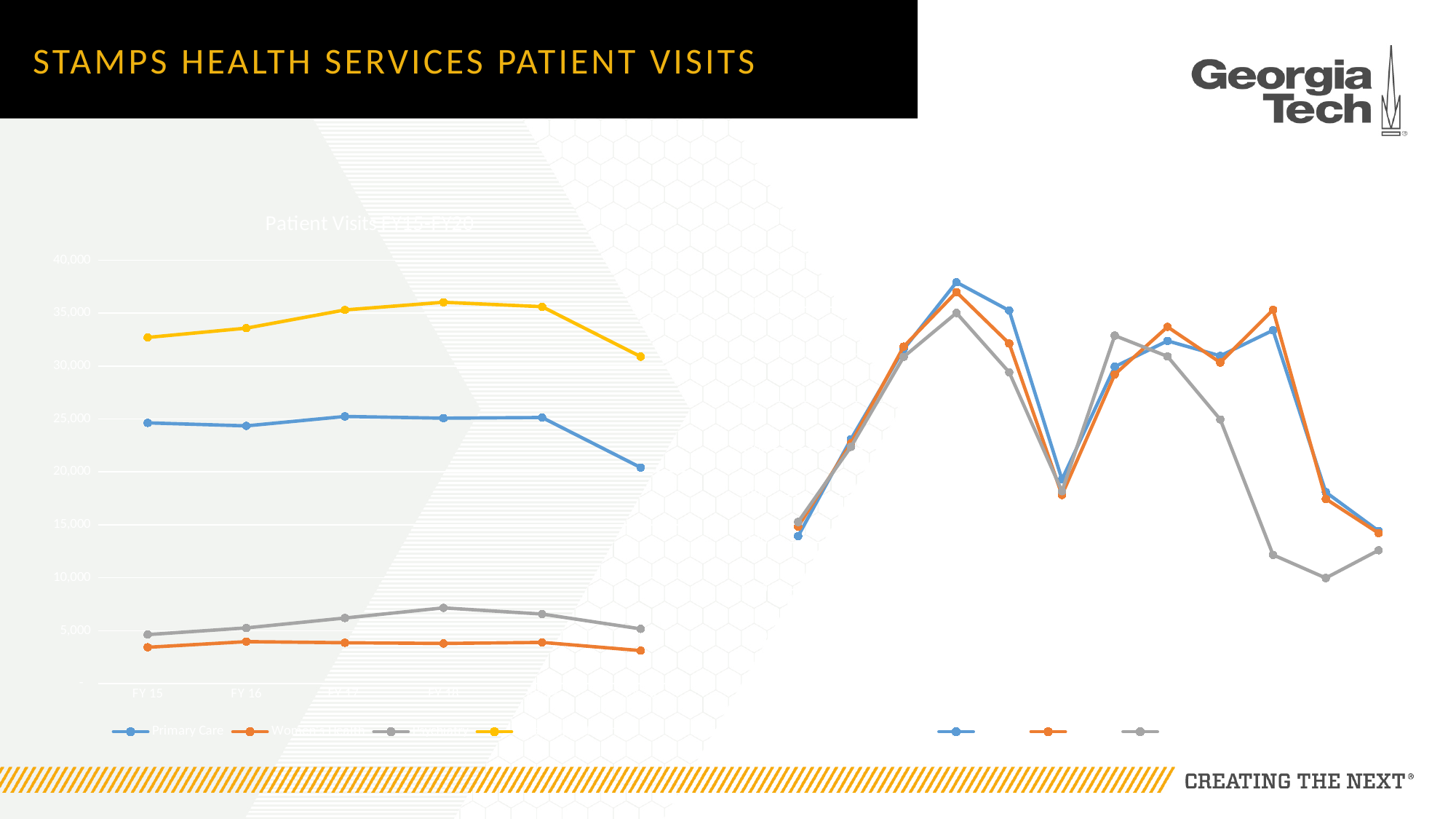
What type of chart is the left chart, titled Patient Visits FY15-FY20? Line chart In the left chart (Patient Visits FY15-FY20), does the Psychiatry line rise or fall from FY 15 to FY 18? Rise In the left chart (Patient Visits FY15-FY20), is the Primary Care value for FY 15 greater or less than 20,000? greater What is the title of the chart on the left side of the slide? Patient Visits FY15-FY20 How many series does the legend of the left chart (Patient Visits FY15-FY20) list? 4 How many series does the legend of the right chart show? 3 In the left chart (Patient Visits FY15-FY20), which of the labeled series has the lowest values throughout? Women's Health In the left chart (Patient Visits FY15-FY20), which is larger at FY 17: Women's Health or Psychiatry? Psychiatry In the left chart (Patient Visits FY15-FY20), is the Women's Health value for FY 16 greater or less than 5,000? less What type of chart is the chart on the right side of the slide? Line chart In the left chart (Patient Visits FY15-FY20), which is larger at FY 15: Primary Care or Psychiatry? Primary Care In the left chart (Patient Visits FY15-FY20), is the Psychiatry value for FY 18 greater or less than 5,000? greater